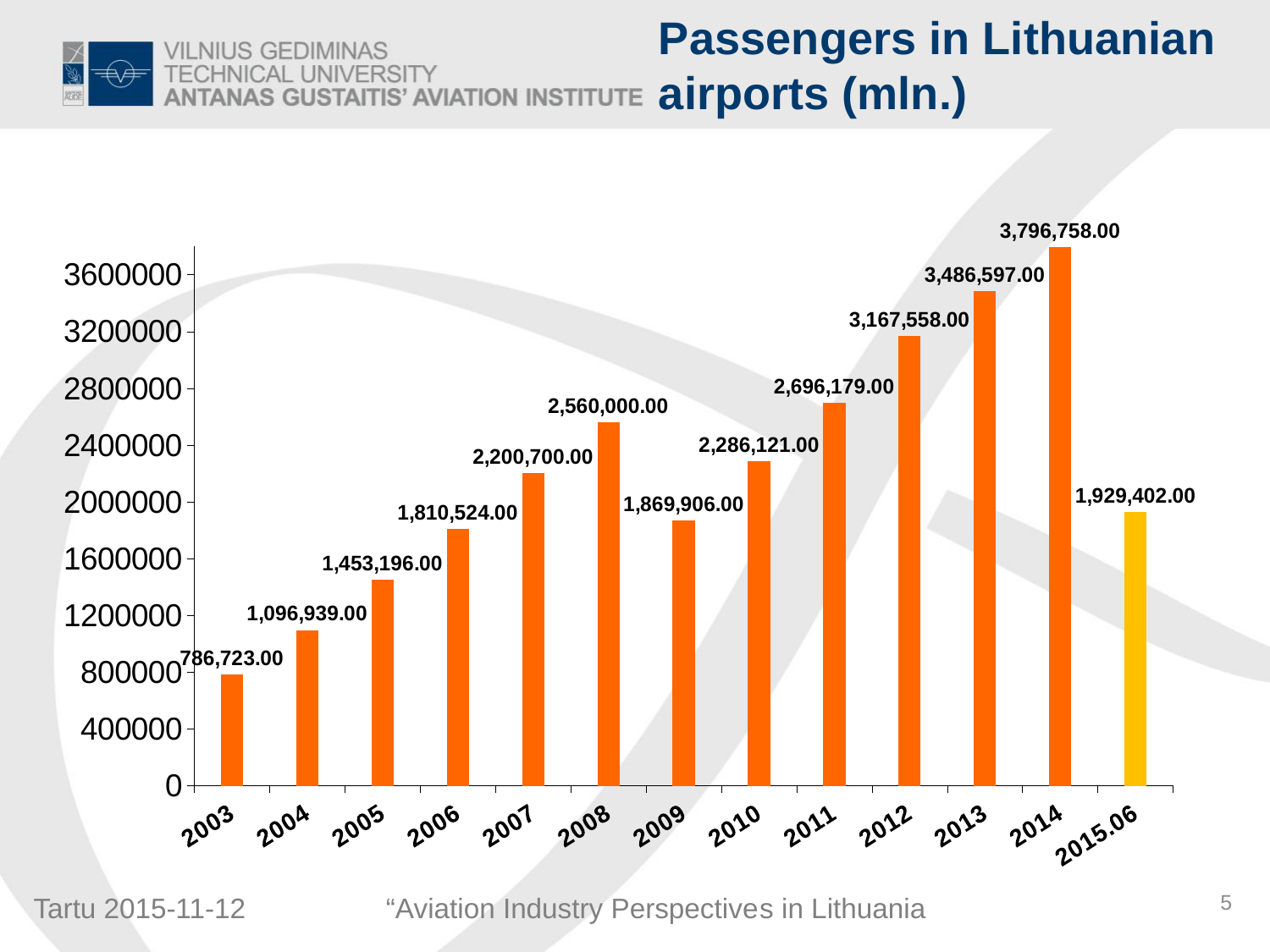
What is the value for 2009? 1,869,906.00 What kind of chart is shown on the slide? bar chart What is the value for 2015.06? 1,929,402.00 Which bar is shown in a different colour (yellow) from the others? 2015.06 Which year has the lowest value? 2003 Which year has the highest value? 2014 What is the value for 2014? 3,796,758.00 Is the value for 2012 greater or less than 2800000? greater What is the difference between the values for 2008 and 2009? 690,094.00 What is the difference between the values for 2014 and 2013? 310,161.00 How many bars are shown in the chart? 13 Which is larger, the value for 2010 or the value for 2007? 2010